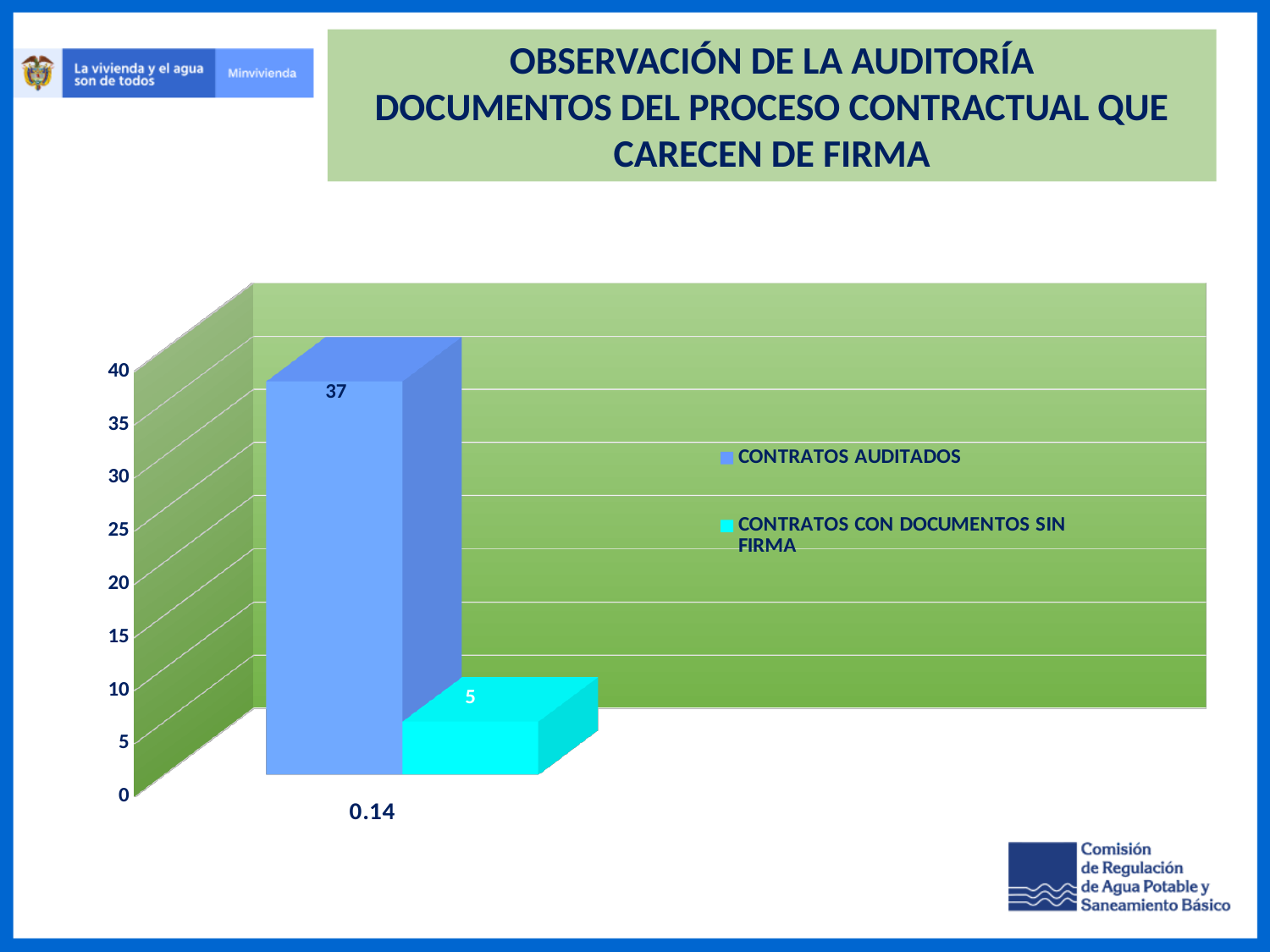
What is the value for CONTRATOS CON DOCUMENTOS SIN FIRMA? 5 What is the value for CONTRATOS AUDITADOS? 37 How many series does the legend list? 2 What is the category label shown on the x axis of the chart? 0.14 Which series has the lowest value? CONTRATOS CON DOCUMENTOS SIN FIRMA Is the value for CONTRATOS AUDITADOS greater or less than 30? greater What is the difference between the value for CONTRATOS AUDITADOS and the value for CONTRATOS CON DOCUMENTOS SIN FIRMA? 32 Which series has the highest value? CONTRATOS AUDITADOS Which is larger, the value for CONTRATOS AUDITADOS or the value for CONTRATOS CON DOCUMENTOS SIN FIRMA? CONTRATOS AUDITADOS What kind of chart is shown on the slide? bar chart Is the value for CONTRATOS CON DOCUMENTOS SIN FIRMA greater or less than 10? less What colour is the bar for CONTRATOS CON DOCUMENTOS SIN FIRMA? cyan